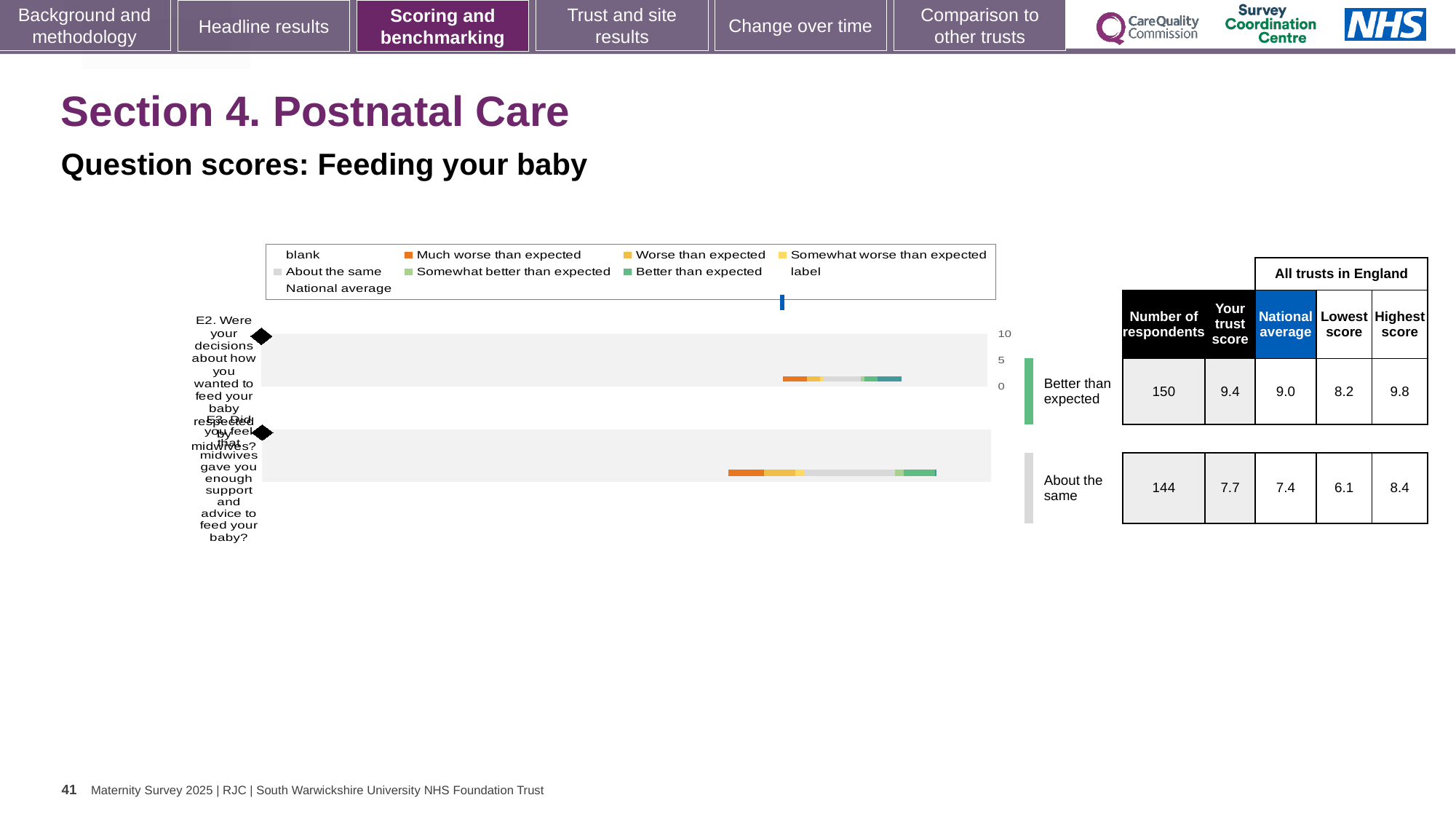
By how much does the trust score for E2 exceed the national average for E2? 0.4 What is the lowest score among all trusts in England for E3? 6.1 What is the national average for E2? 9.0 How is the trust's result for E3 categorised relative to expectation? About the same What is the trust score for E3 (midwives gave you enough support and advice to feed your baby)? 7.7 How many questions (categories) are plotted in the chart? 2 How is the trust's result for E2 categorised relative to expectation? Better than expected What is the trust score for E2 (decisions about how you wanted to feed your baby respected by midwives)? 9.4 What is the highest score among all trusts in England for E2? 9.8 What kind of chart is shown on the slide? bar chart Which question has the higher trust score, E2 or E3? E2 What is the number of respondents for E3? 144